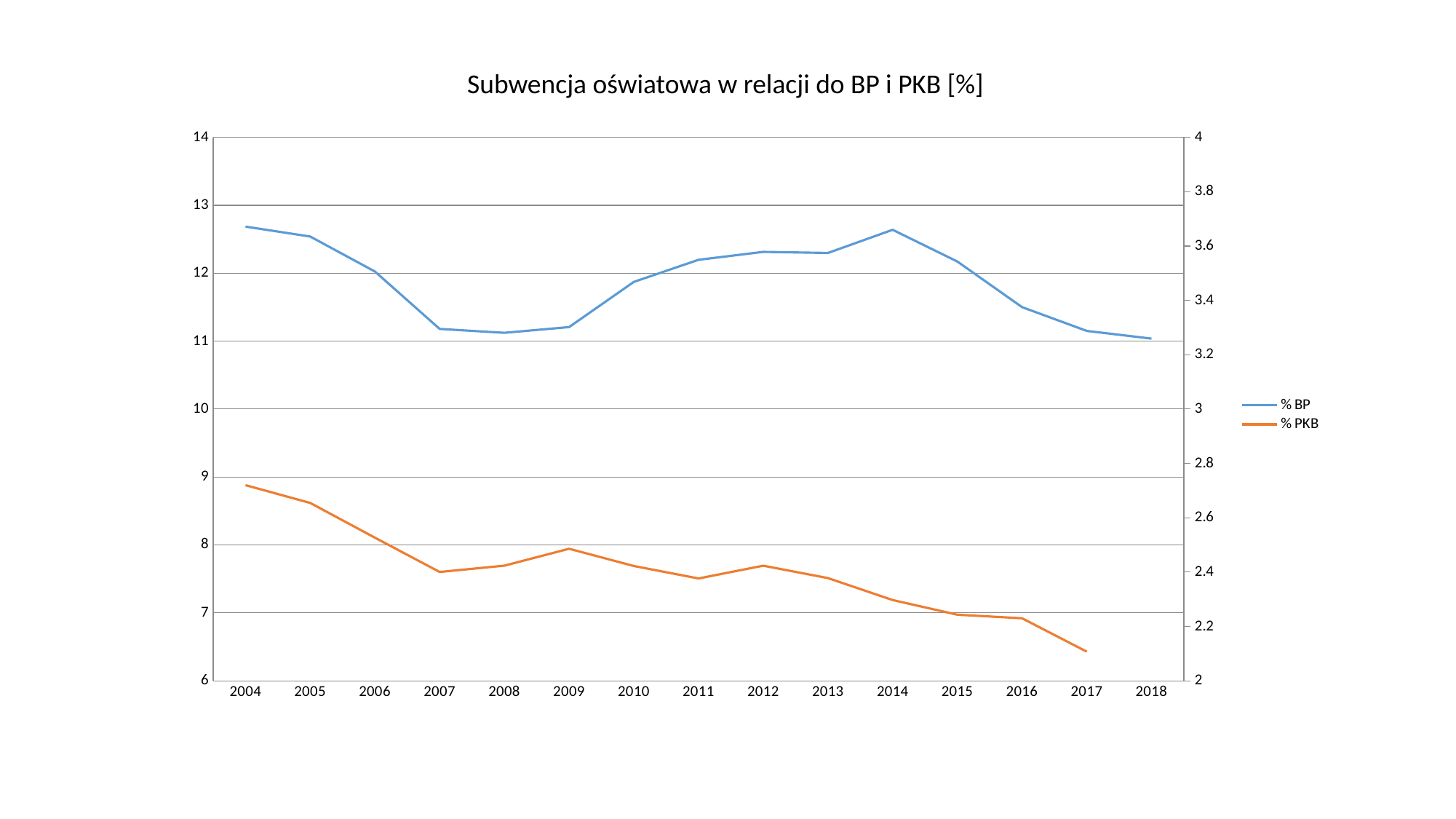
How many series does the legend list? 2 What kind of chart is shown on the slide? line chart Does the % PKB series generally rise or fall from 2004 to 2017? fall How many years are shown on the x axis? 15 Which colour is used for the % PKB series? orange What is the title of the chart? Subwencja oświatowa w relacji do BP i PKB [%] In which year is the % PKB series at its highest? 2004 Is the % BP value for 2007 greater or less than 12? less In which year is the % PKB series at its lowest? 2017 Is the % BP value for 2014 greater or less than 12? greater Which year has the higher % BP value, 2011 or 2016? 2011 Is the % PKB value for 2017 greater or less than 2.2 on the right axis? less